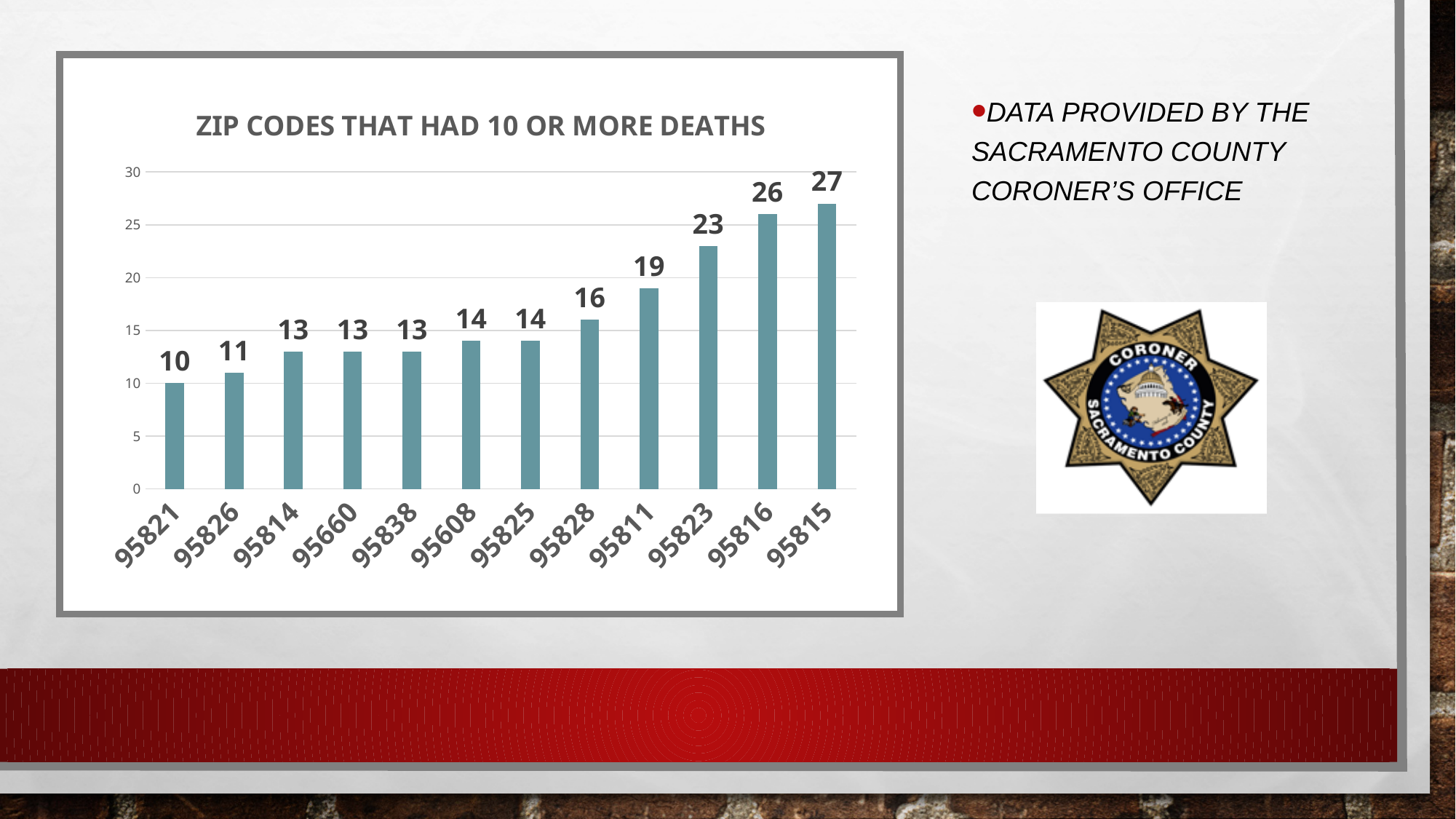
What is the title of the chart? ZIP CODES THAT HAD 10 OR MORE DEATHS What is the difference between the values for 95815 and 95821? 17 What is the value for zip code 95660? 13 Which has a larger value, 95816 or 95811? 95816 How many zip codes are shown in the chart? 12 Is the value for 95823 greater or less than 20? greater What kind of chart is shown on the slide? Bar chart Which zip code has the lowest number of deaths? 95821 Which zip code has the highest number of deaths? 95815 What is the value for zip code 95815? 27 What is the value for zip code 95811? 19 What is the difference between the values for 95823 and 95828? 7